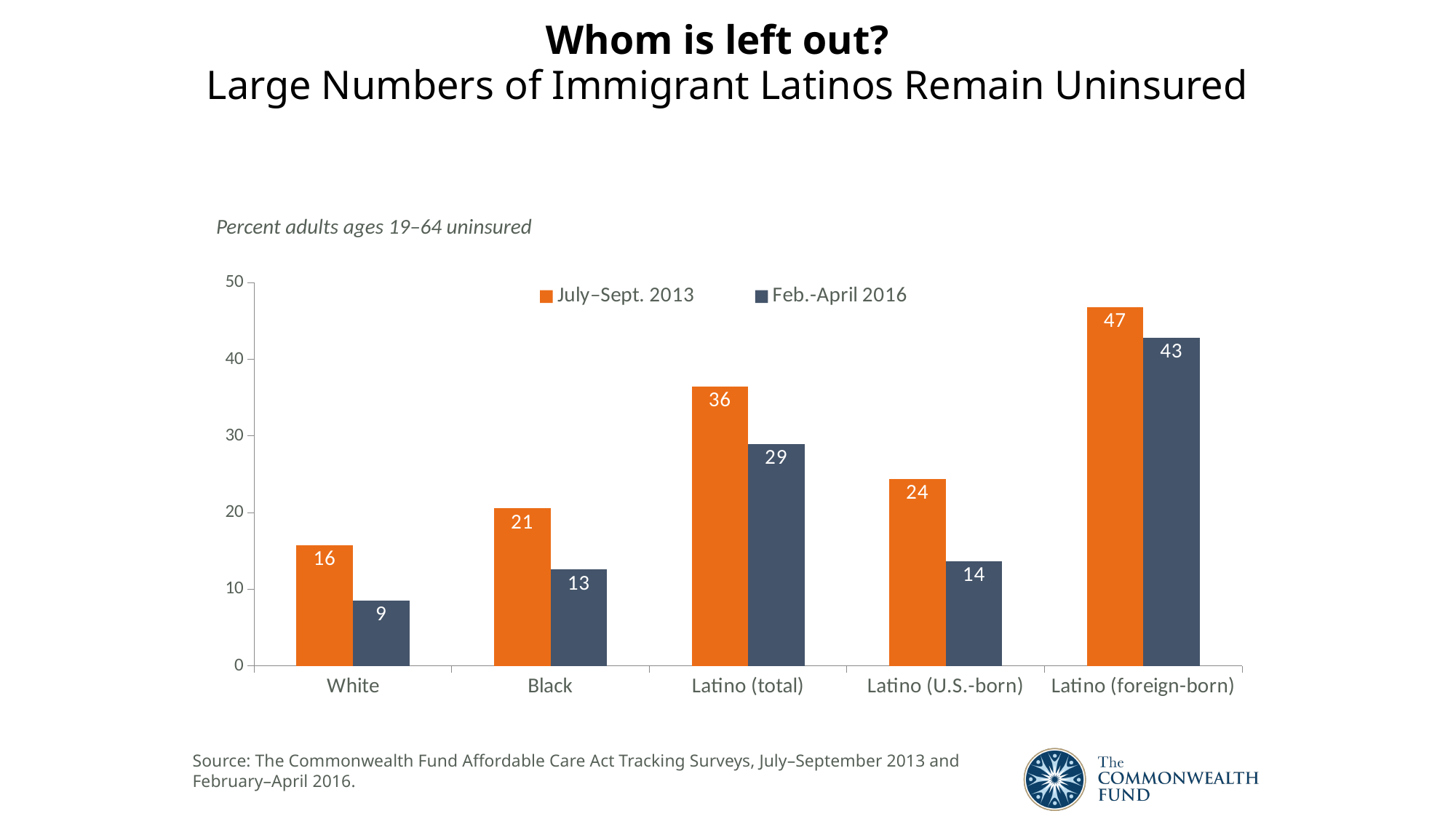
What is the difference between the July–Sept. 2013 and Feb.-April 2016 values for Latino (U.S.-born)? 10 What does the label above the chart say the values represent? Percent adults ages 19–64 uninsured What is the value for White in the Feb.-April 2016 series? 9 Is the July–Sept. 2013 value for Latino (total) greater or less than 30? greater Which is larger: the Feb.-April 2016 value for Black or the Feb.-April 2016 value for Latino (total)? Latino (total) How many categories are shown on the x axis? 5 How many series does the legend list? 2 What kind of chart is shown on the slide? bar chart Which category has the lowest value in the July–Sept. 2013 series? White What is the value for Latino (U.S.-born) in the Feb.-April 2016 series? 14 What is the value for Latino (foreign-born) in the July–Sept. 2013 series? 47 Which category has the highest value in the Feb.-April 2016 series? Latino (foreign-born)